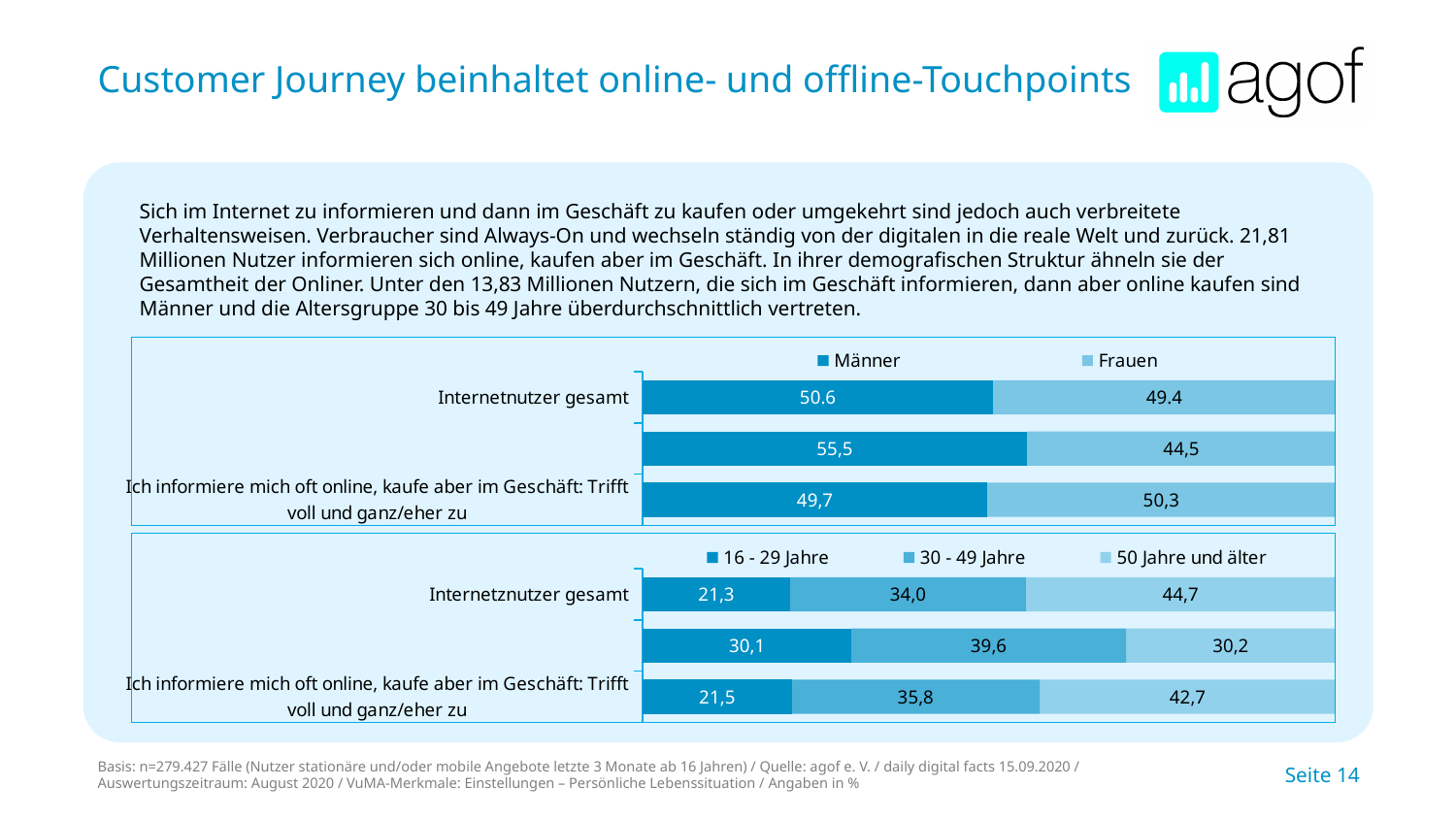
In the bottom chart (age groups), what is the difference between '30 - 49 Jahre' and '16 - 29 Jahre' in the bar 'Ich informiere mich oft online, kaufe aber im Geschäft: Trifft voll und ganz/eher zu'? 14,3 How many bars are shown in the top chart (Männer/Frauen)? 3 In the bottom chart (age groups), what is the value for '16 - 29 Jahre' in the bar 'Ich informiere mich oft online, kaufe aber im Geschäft: Trifft voll und ganz/eher zu'? 21,5 In the top chart (Männer/Frauen), which is larger in the bar 'Ich informiere mich oft online, kaufe aber im Geschäft: Trifft voll und ganz/eher zu', Männer or Frauen? Frauen In the top chart (Männer/Frauen), what is the value for Frauen in the bar 'Ich informiere mich oft online, kaufe aber im Geschäft: Trifft voll und ganz/eher zu'? 50,3 In the bottom chart (age groups), which age group has the largest share in the Internetnutzer gesamt bar? 50 Jahre und älter How many series does the legend of the top chart list? 2 What are the legend entries of the bottom chart? 16 - 29 Jahre, 30 - 49 Jahre, 50 Jahre und älter In the bottom chart (age groups), what is the value for '50 Jahre und älter' in the Internetnutzer gesamt bar? 44,7 In the top chart (Männer/Frauen), what is the value for Männer in the Internetnutzer gesamt bar? 50.6 How many series does the legend of the bottom chart (age groups) list? 3 What kind of chart is the bottom chart on the slide? Stacked bar chart